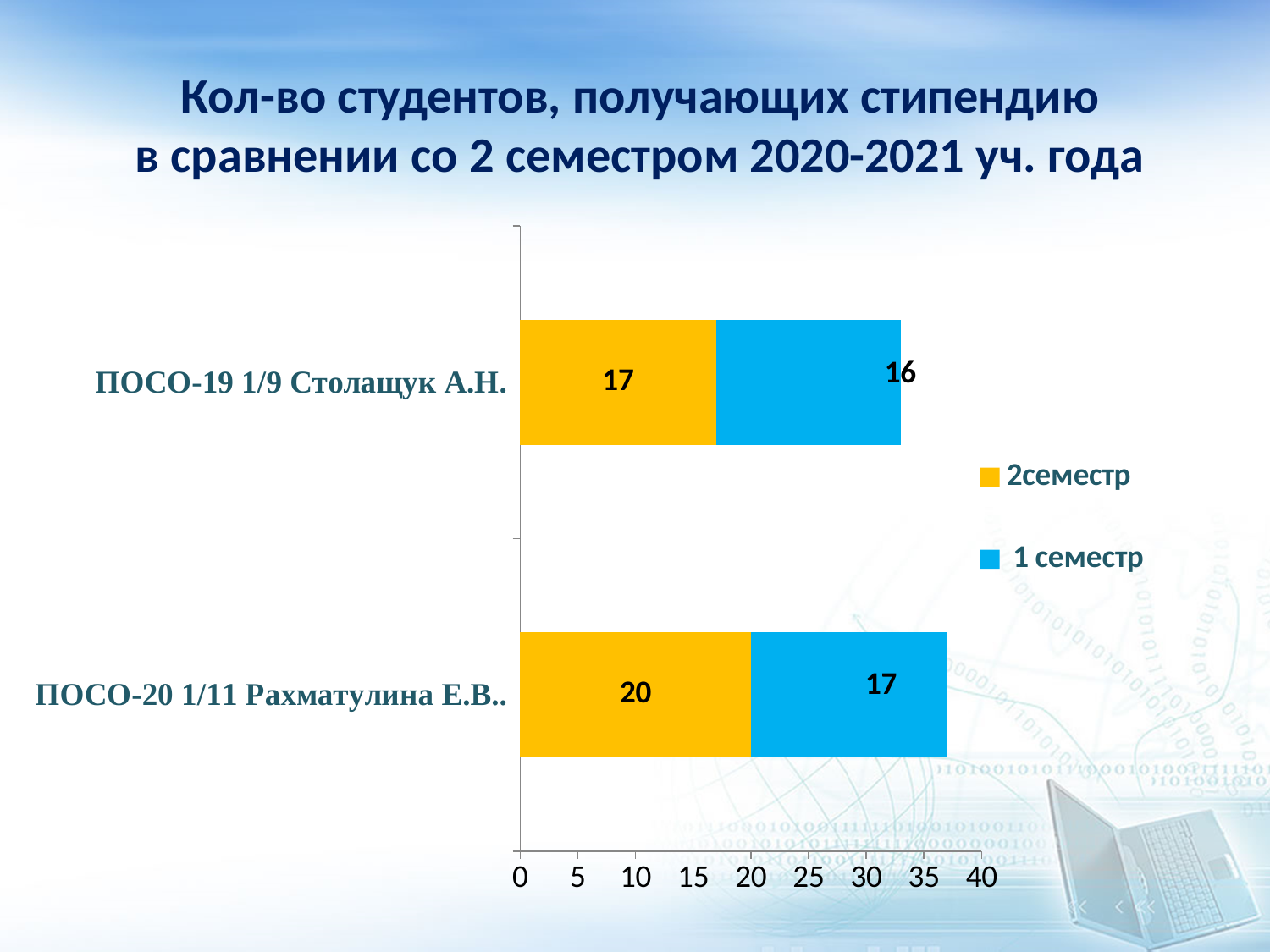
What is the value for 2семестр for ПОСО-19 1/9 Столащук А.Н.? 17 What is the total of the stacked bar for ПОСО-19 1/9 Столащук А.Н.? 33 What is the value for 1 семестр for ПОСО-20 1/11 Рахматулина Е.В..? 17 Which category has the lowest value for 1 семестр? ПОСО-19 1/9 Столащук А.Н. What is the value for 1 семестр for ПОСО-19 1/9 Столащук А.Н.? 16 What is the value for 2семестр for ПОСО-20 1/11 Рахматулина Е.В..? 20 What is the total of the stacked bar for ПОСО-20 1/11 Рахматулина Е.В..? 37 How many categories are shown on the chart? 2 Which category has the highest value for 2семестр? ПОСО-20 1/11 Рахматулина Е.В.. What is the difference between the 2семестр values for ПОСО-20 1/11 Рахматулина Е.В.. and ПОСО-19 1/9 Столащук А.Н.? 3 How many series does the legend list? 2 What kind of chart is shown on the slide? Stacked bar chart